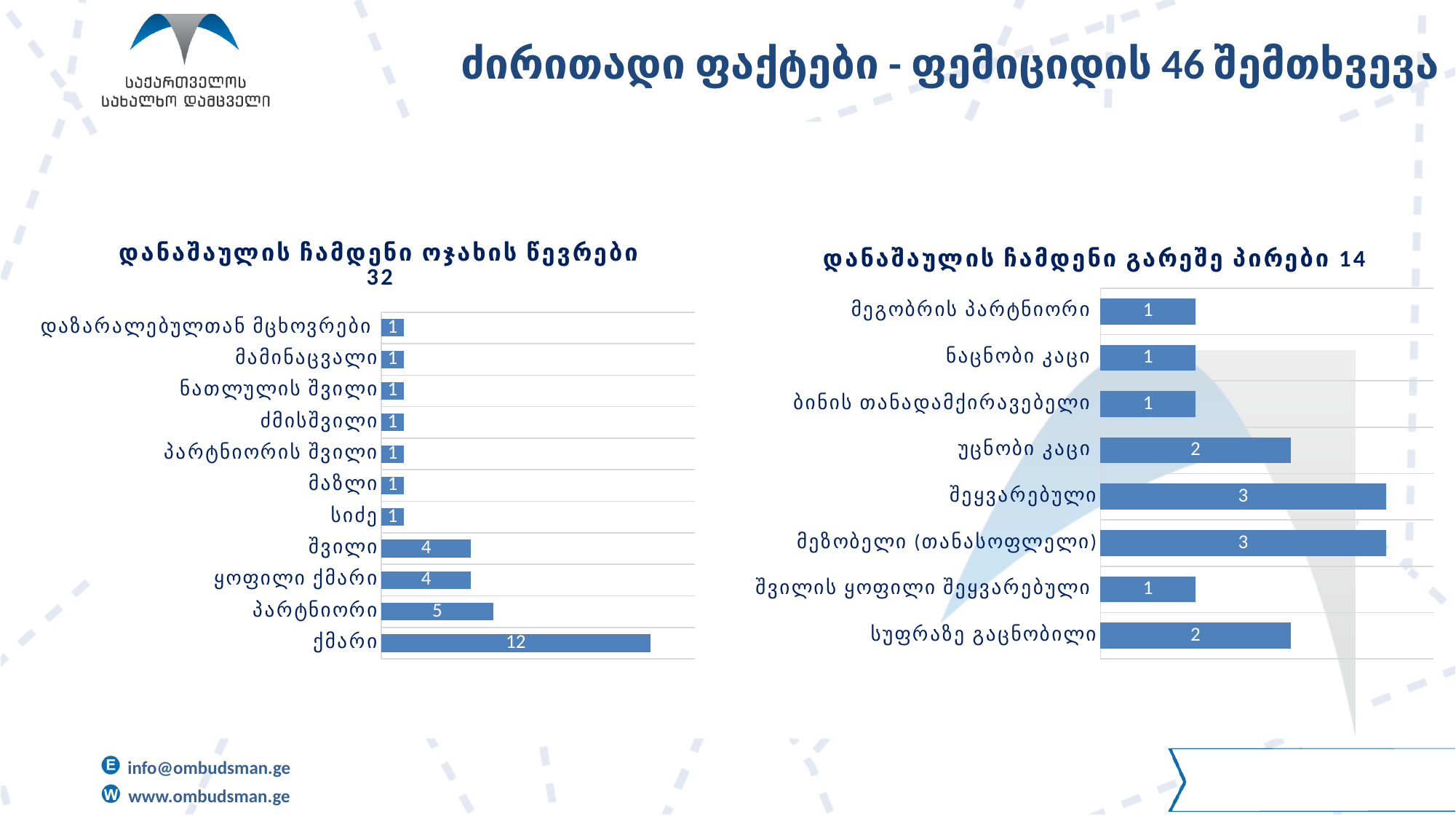
In the left chart (დანაშაულის ჩამდენი ოჯახის წევრები 32), what is the value for ქმარი? 12 In the right chart (დანაშაულის ჩამდენი გარეშე პირები 14), which is larger, the value for სუფრაზე გაცნობილი or the value for ნაცნობი კაცი? სუფრაზე გაცნობილი In the left chart (დანაშაულის ჩამდენი ოჯახის წევრები 32), how many categories are plotted? 11 In the left chart (დანაშაულის ჩამდენი ოჯახის წევრები 32), which is larger, the value for შვილი or the value for პარტნიორი? პარტნიორი In the right chart (დანაშაულის ჩამდენი გარეშე პირები 14), what is the difference between the values for მეზობელი (თანასოფლელი) and მეგობრის პარტნიორი? 2 In the left chart (დანაშაულის ჩამდენი ოჯახის წევრები 32), which category has the highest value? ქმარი In the right chart (დანაშაულის ჩამდენი გარეშე პირები 14), how many categories are plotted? 8 In the left chart (დანაშაულის ჩამდენი ოჯახის წევრები 32), what is the difference between the values for ქმარი and პარტნიორი? 7 In the right chart (დანაშაულის ჩამდენი გარეშე პირები 14), what is the value for უცნობი კაცი? 2 In the left chart (დანაშაულის ჩამდენი ოჯახის წევრები 32), what is the value for პარტნიორი? 5 In the right chart (დანაშაულის ჩამდენი გარეშე პირები 14), what is the value for შეყვარებული? 3 What type of chart is the left chart (დანაშაულის ჩამდენი ოჯახის წევრები 32)? Bar chart